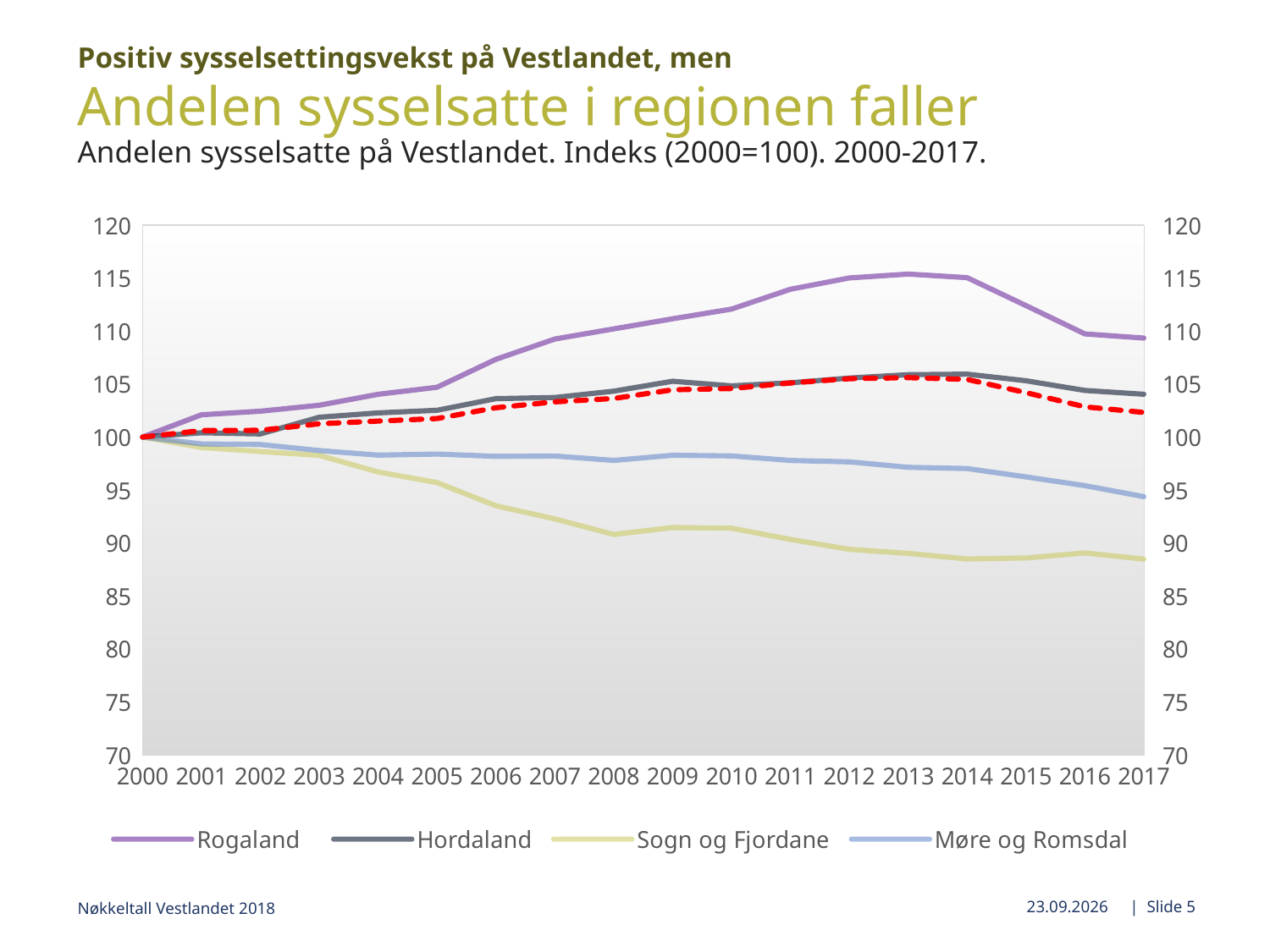
What is the index value for Rogaland in 2000? 100 What kind of chart is shown on the slide? line chart Is the value for Rogaland in 2011 greater or less than 110? greater In 2010, which is larger: Hordaland or Møre og Romsdal? Hordaland How many series does the legend list? 4 What is the subtitle describing the chart? Andelen sysselsatte på Vestlandet. Indeks (2000=100). 2000-2017. Does the Sogn og Fjordane line rise or fall from 2000 to 2017? fall Which series has the highest value in 2017? Rogaland Is the value for Sogn og Fjordane in 2017 greater or less than 90? less Is the value for Hordaland in 2017 greater or less than 100? greater How many years are shown along the x axis? 18 Which series has the lowest value in 2017? Sogn og Fjordane